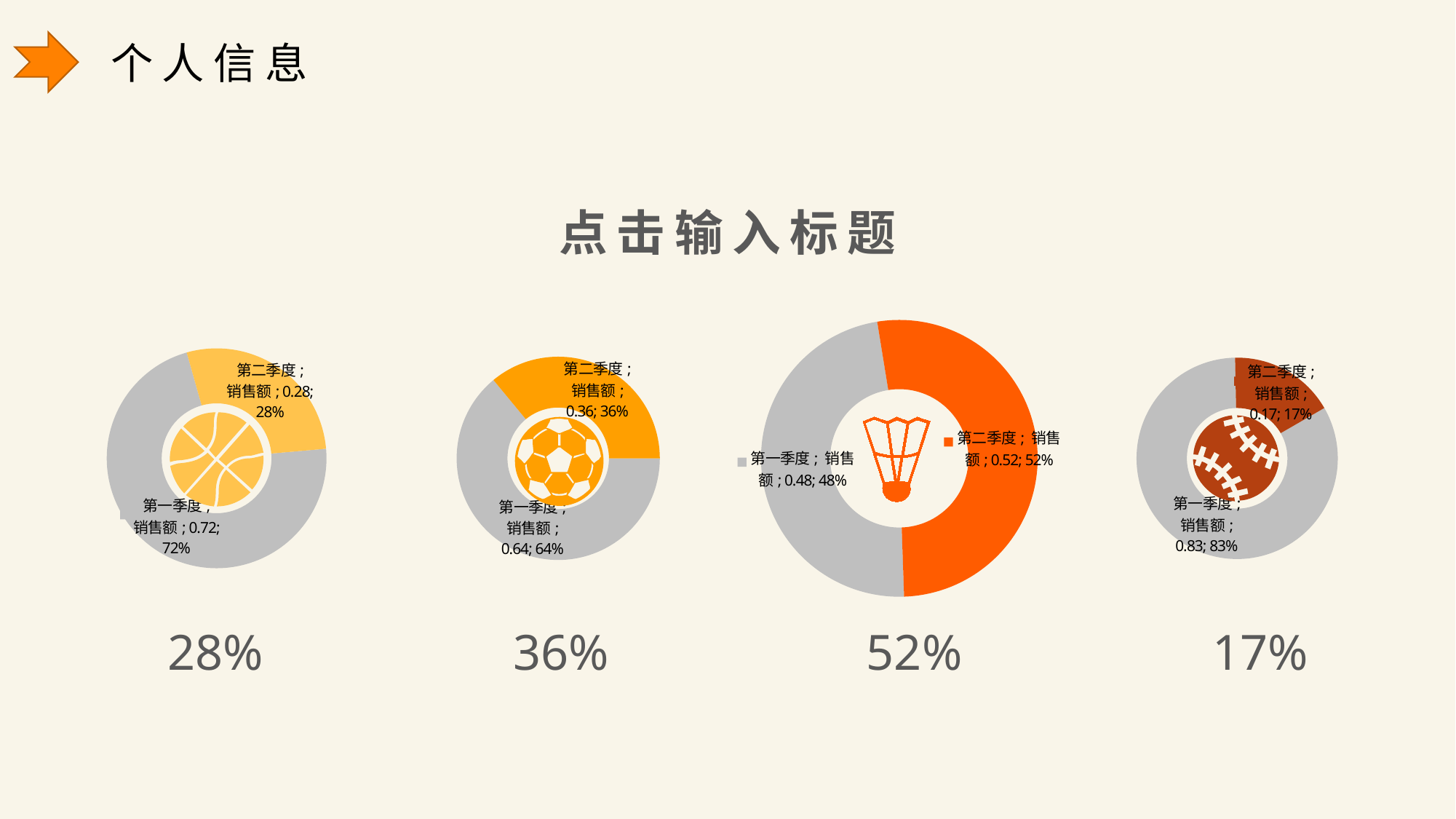
In the rightmost chart (labelled 17% below), what is the value shown for 第一季度? 0.83 In the third chart from the left (labelled 52% below), what share of the pie does 第二季度 take? 52% In the third chart from the left (labelled 52% below), which slice is larger, 第一季度 or 第二季度? 第二季度 How many slices does the leftmost chart (labelled 28% below) have? 2 In the second chart from the left (labelled 36% below), what share of the pie does 第一季度 take? 64% In the rightmost chart (labelled 17% below), which slice is the largest? 第一季度 In the rightmost chart (labelled 17% below), what is the difference in percentage points between the 第一季度 and 第二季度 shares? 66% What kind of chart is the third chart from the left (labelled 52% below)? Doughnut (pie) chart In the second chart from the left (labelled 36% below), what is the value shown for 第二季度? 0.36 In the leftmost chart (labelled 28% below), what share of the pie does 第二季度 take? 28% In the leftmost chart (labelled 28% below), what is the value shown for 第一季度? 0.72 How many doughnut charts are shown on the slide? 4